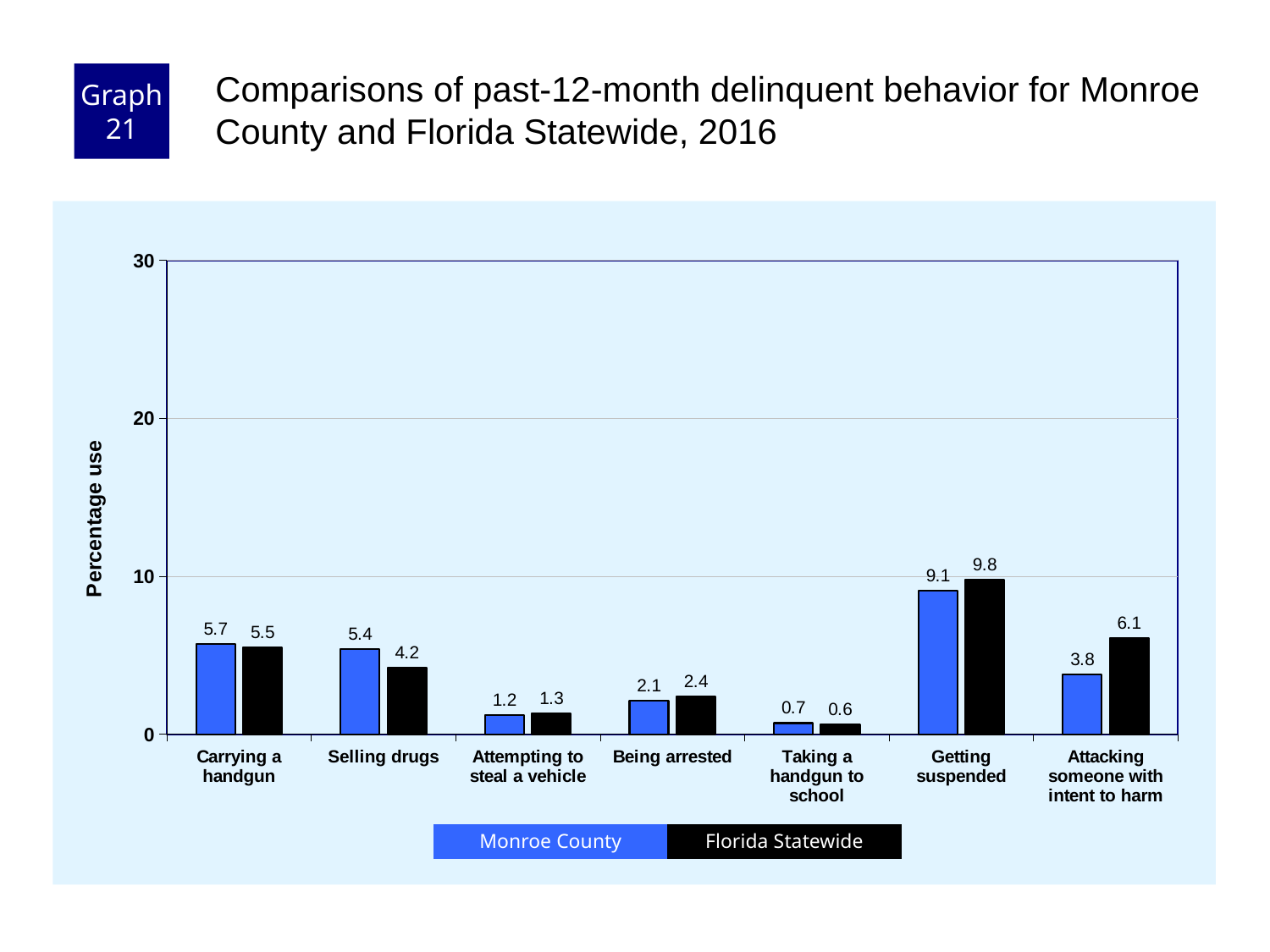
What kind of chart is shown on the slide? bar chart What is the difference between the Monroe County and Florida Statewide values for Selling drugs? 1.2 Which category has the lowest Monroe County value? Taking a handgun to school What is the difference between the Florida Statewide and Monroe County values for Attacking someone with intent to harm? 2.3 Which category has the highest Florida Statewide value? Getting suspended What is the Monroe County value for Taking a handgun to school? 0.7 How many categories are shown on the x axis? 7 For Being arrested, which is larger: Monroe County or Florida Statewide? Florida Statewide What is the Florida Statewide value for Attacking someone with intent to harm? 6.1 What is the Monroe County value for Getting suspended? 9.1 How many series does the legend list? 2 Is the Florida Statewide value for Getting suspended greater or less than 10? less